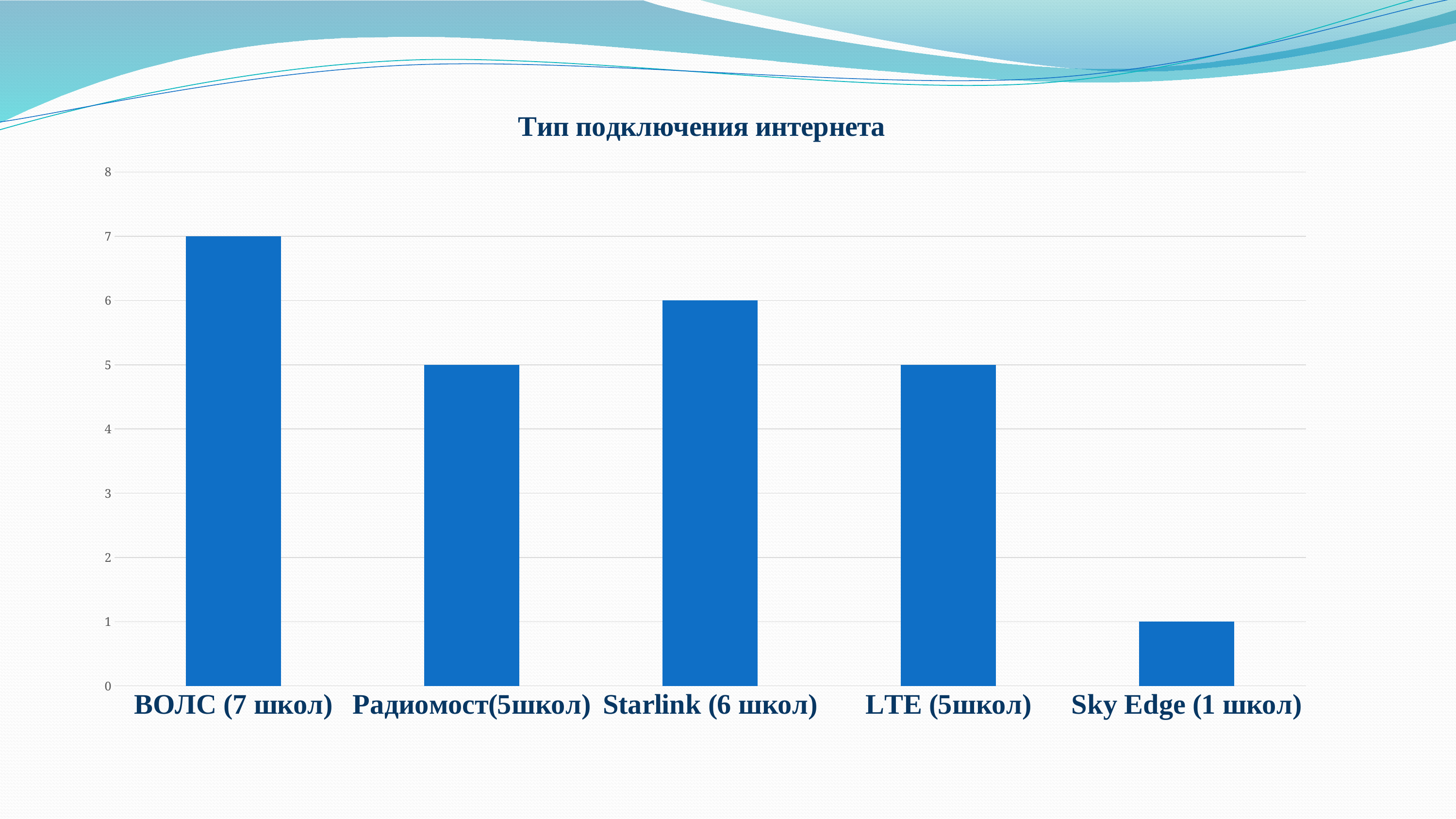
What is the difference between the values for ВОЛС (7 школ) and Starlink (6 школ)? 1 What is the value for Sky Edge (1 школ)? 1 Which category has the lowest value? Sky Edge (1 школ) What is the difference between the values for Starlink (6 школ) and Sky Edge (1 школ)? 5 What is the value for ВОЛС (7 школ)? 7 How many categories are shown on the x axis? 5 What kind of chart is shown on the slide? bar chart Which category has the highest value? ВОЛС (7 школ) What is the title of the chart? Тип подключения интернета What is the value for Starlink (6 школ)? 6 Is the value for Радиомост(5школ) greater or less than 4? greater Which is larger, the value for Starlink (6 школ) or the value for LTE (5школ)? Starlink (6 школ)